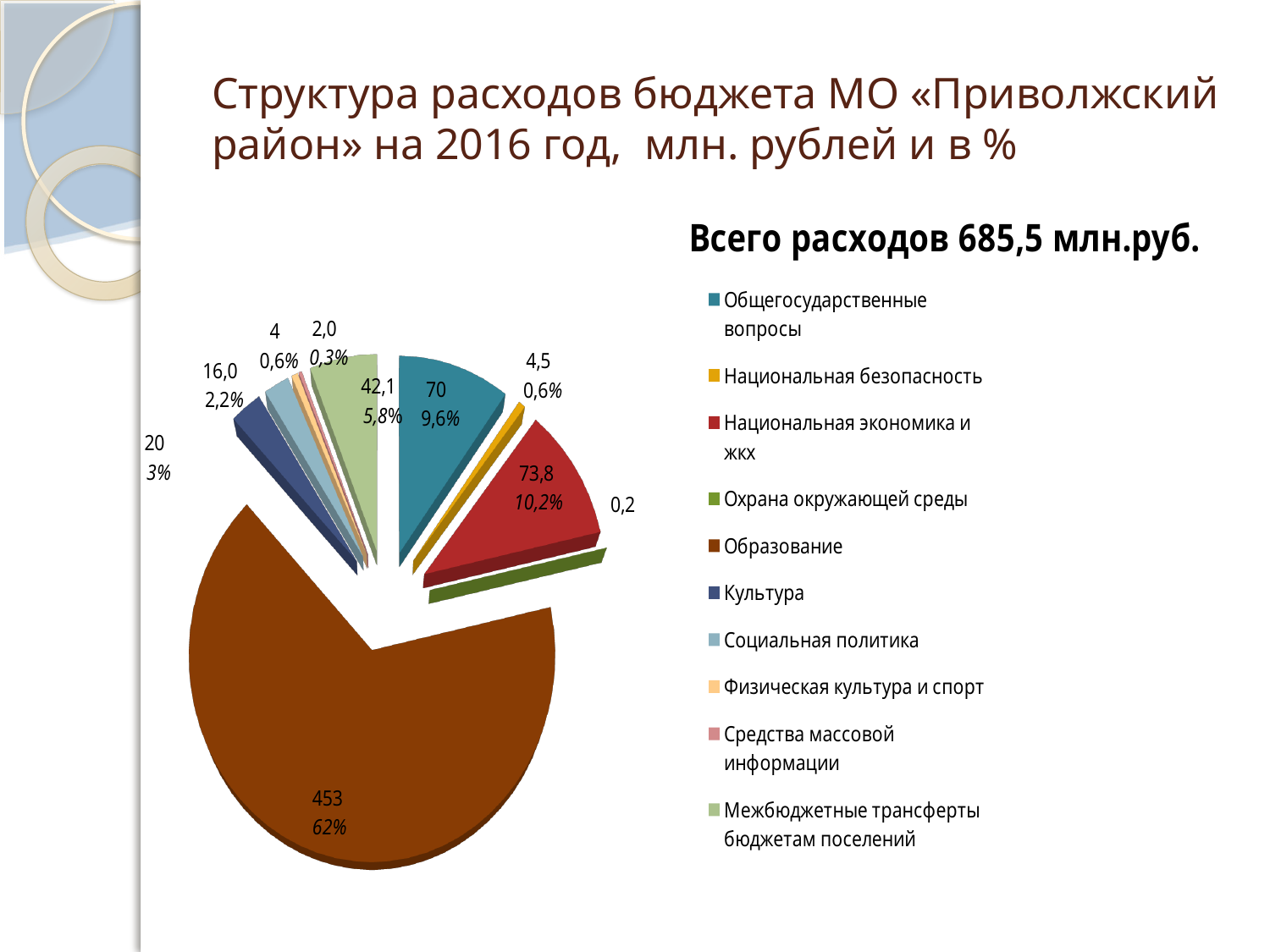
Which is larger: the value for Национальная экономика и ЖКХ or the value for Общегосударственные вопросы? Национальная экономика и ЖКХ What total expenditure is stated in the chart title? 685,5 млн.руб. What value is shown for Национальная экономика и ЖКХ? 73,8 Which category has the largest slice of the pie? Образование What value is shown for Образование in the pie chart? 453 What value is shown for Социальная политика? 16,0 What share of the pie does Общегосударственные вопросы represent? 9,6% What share of the pie does Образование represent? 62% What kind of chart is shown on the slide? Pie chart What is the difference between the values for Межбюджетные трансферты бюджетам поселений (42,1) and Культура (20)? 22,1 Which category has the smallest slice of the pie? Охрана окружающей среды How many categories does the legend of the pie chart list? 10